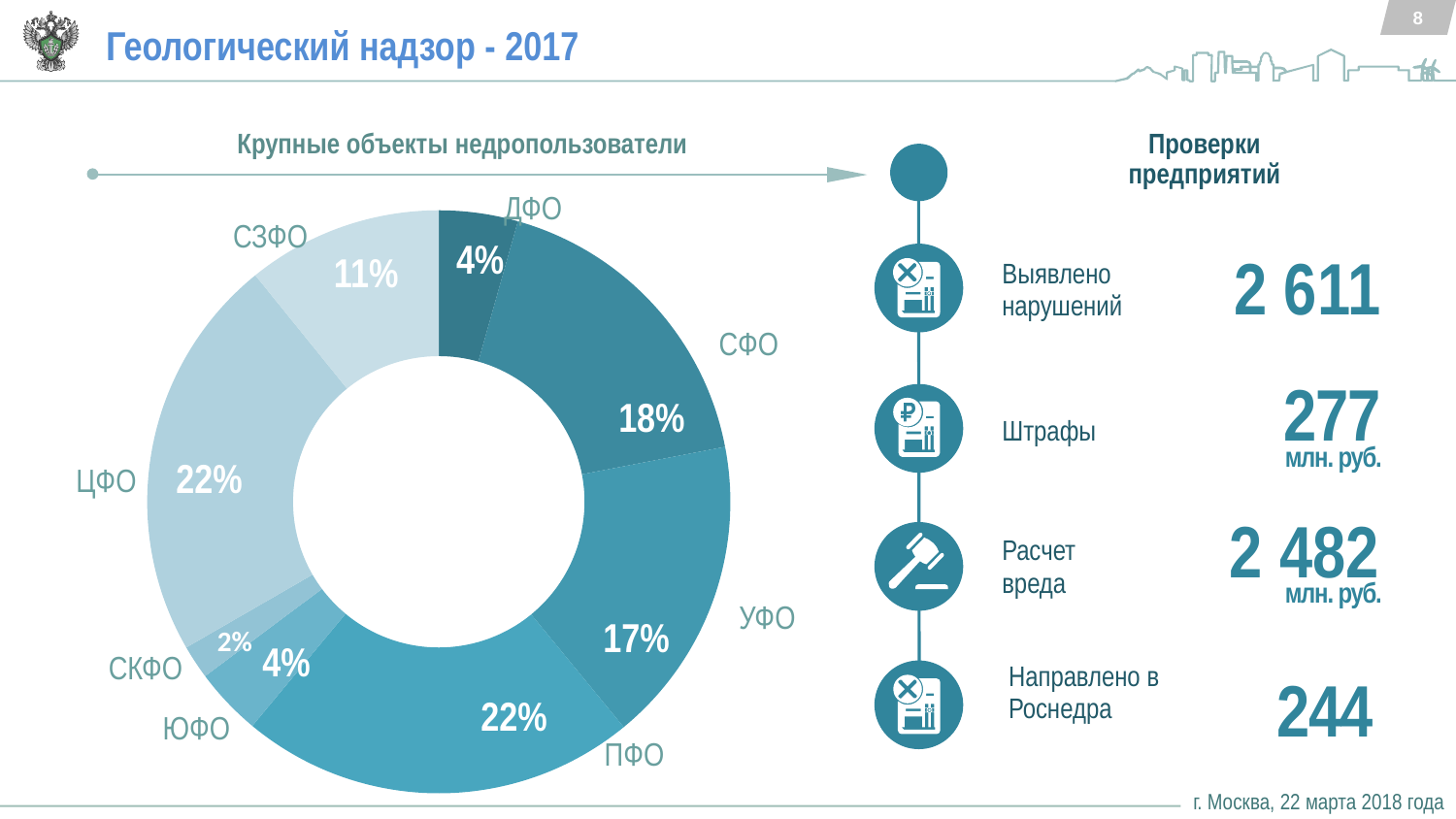
What is the value for УФО in the chart? 17% What is the difference between the shares of ЦФО and СЗФО? 11% Which region has the smallest share in the donut chart? СКФО How many regions (categories) are shown in the donut chart? 8 What share of the donut chart does СФО account for? 18% Which has a larger share, СЗФО or ЮФО? СЗФО What percentage is shown for СЗФО? 11% What is the difference between the shares of СФО and УФО? 1% What type of chart is used to show the regional shares? Donut (pie) chart What is the value shown for ЦФО in the donut chart? 22% Which has a larger share, СФО or ДФО? СФО What is the title of the chart on the slide? Крупные объекты недропользователи